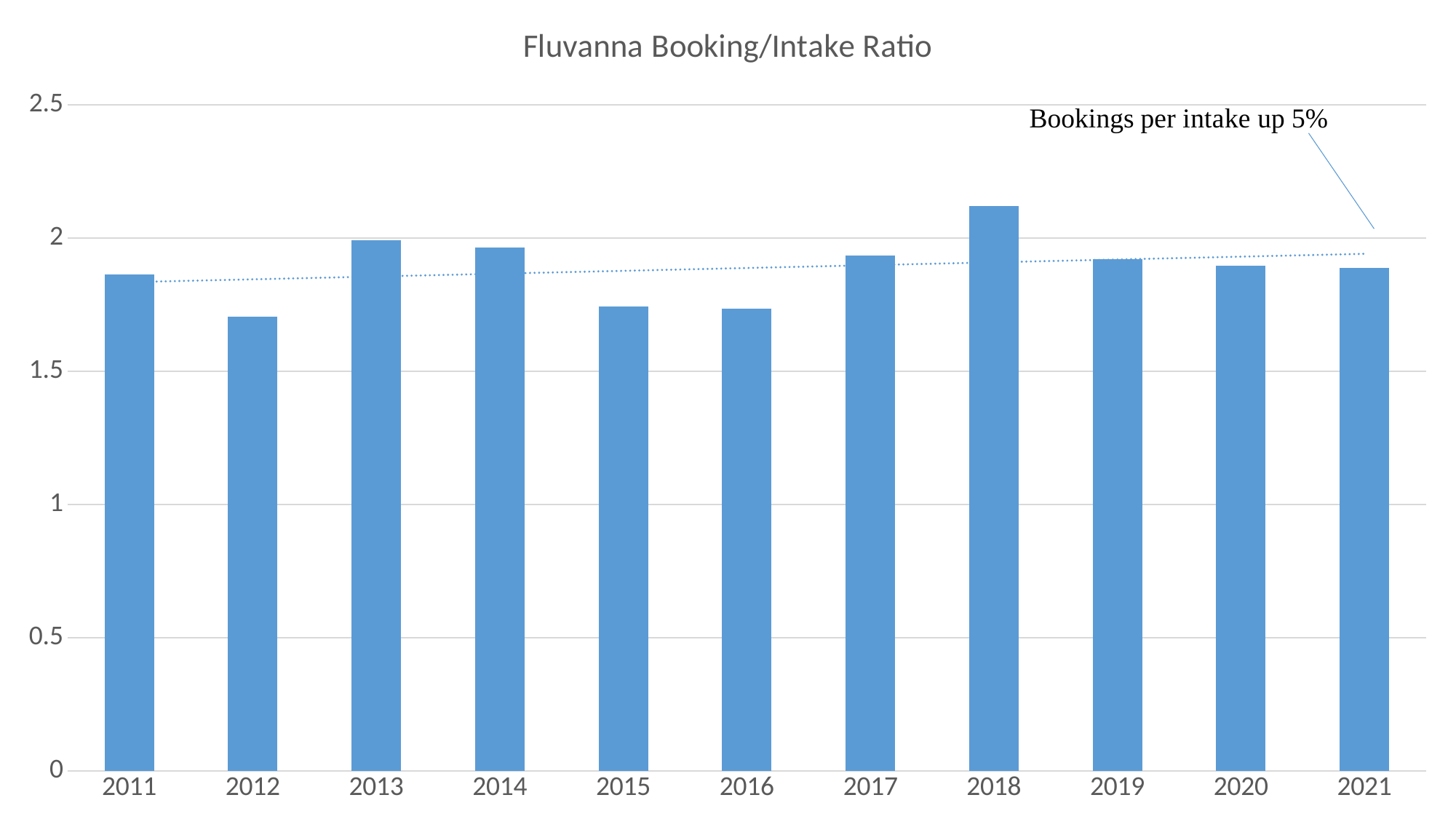
Is the value for 2016 greater or less than 1.5? greater Which year has the highest booking/intake ratio? 2018 Which is larger, the value for 2011 or the value for 2012? 2011 What kind of chart is shown on the slide? bar chart Is the value for 2018 greater or less than 2? greater How many years are plotted on the x axis? 11 What is the title of the chart? Fluvanna Booking/Intake Ratio According to the dotted trendline, does the booking/intake ratio rise or fall from 2011 to 2021? rise What does the annotation text on the chart say? Bookings per intake up 5% Which is larger, the value for 2018 or the value for 2012? 2018 Which is larger, the value for 2013 or the value for 2016? 2013 Is the value for 2012 greater or less than 2? less